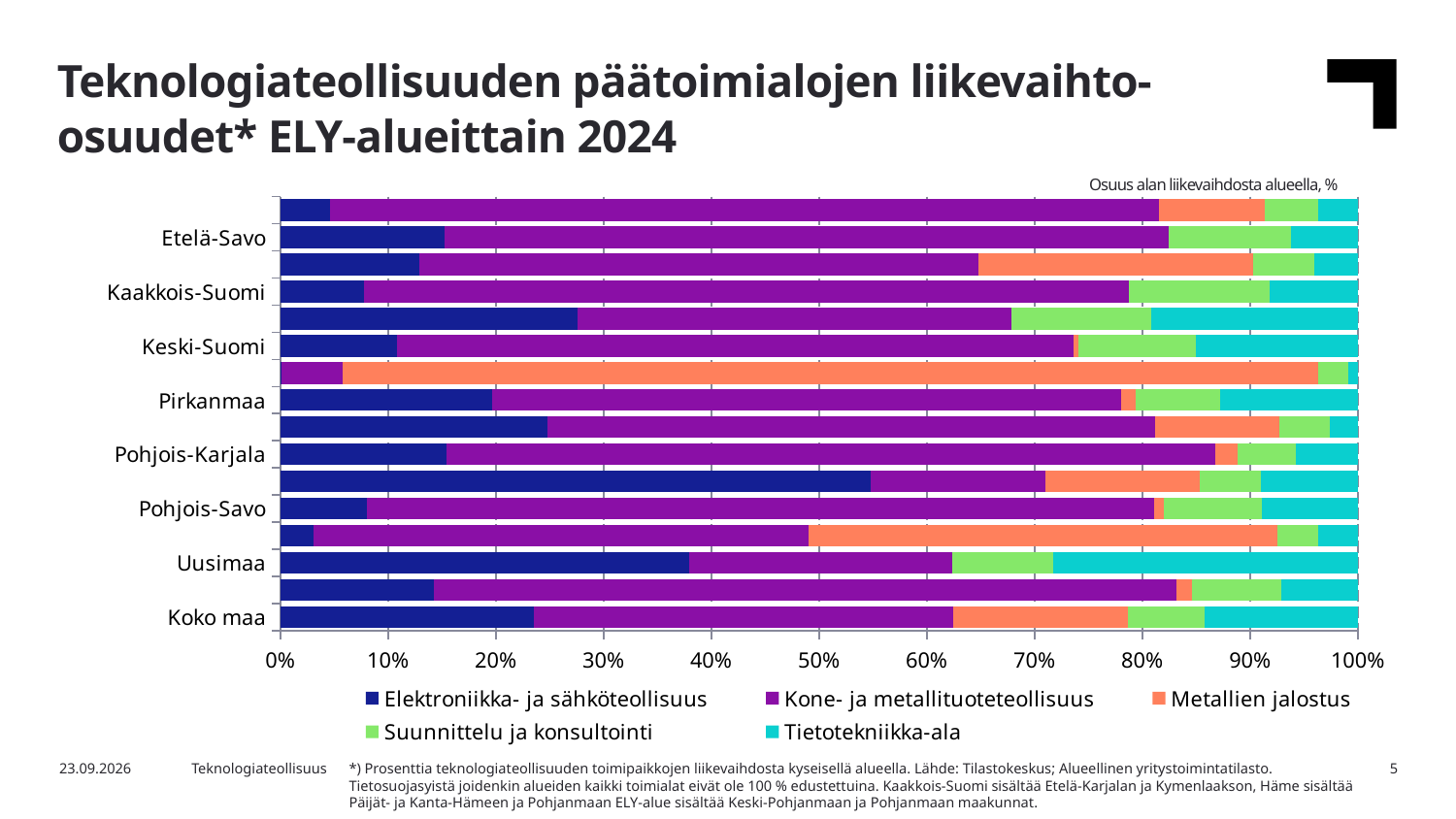
What kind of chart is shown on the slide? Stacked bar chart Is the value for Elektroniikka- ja sähköteollisuus in Uusimaa greater or less than 30%? greater Is the value for Elektroniikka- ja sähköteollisuus in Koko maa greater or less than 30%? less What unit note is shown above the chart? Osuus alan liikevaihdosta alueella, % Which has the larger share of Elektroniikka- ja sähköteollisuus, Etelä-Savo or Kaakkois-Suomi? Etelä-Savo Is the value for Metallien jalostus in Koko maa greater or less than 10%? greater Which has the larger share of Kone- ja metallituoteteollisuus, Pohjois-Karjala or Uusimaa? Pohjois-Karjala Which has the larger share of Elektroniikka- ja sähköteollisuus, Uusimaa or Koko maa? Uusimaa What is the title of the chart on the slide? Teknologiateollisuuden päätoimialojen liikevaihto-osuudet* ELY-alueittain 2024 How many series does the legend list? 5